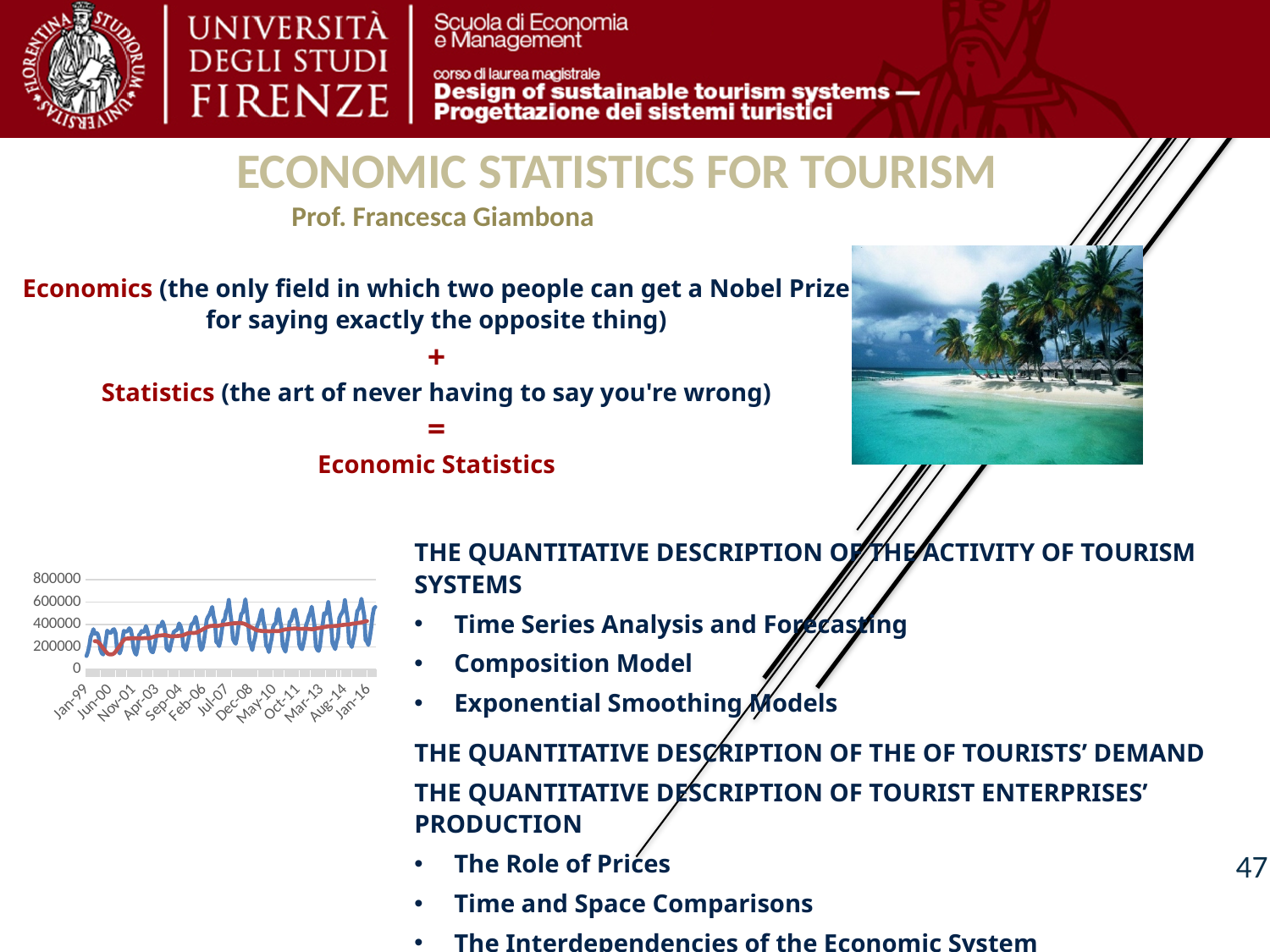
How many labels are shown on the x axis of the chart at the bottom left? 13 In the chart at the bottom left, do the values generally rise or fall from Jan-99 to Jan-16? rise In the chart at the bottom left, is the highest value of the blue line greater or less than 400000? greater What kind of chart is shown at the bottom left of the slide? line chart What is the first label on the x axis of the chart at the bottom left? Jan-99 In the chart at the bottom left, is the highest value of the blue line greater or less than 800000? less What is the highest tick value shown on the y axis of the chart at the bottom left? 800000